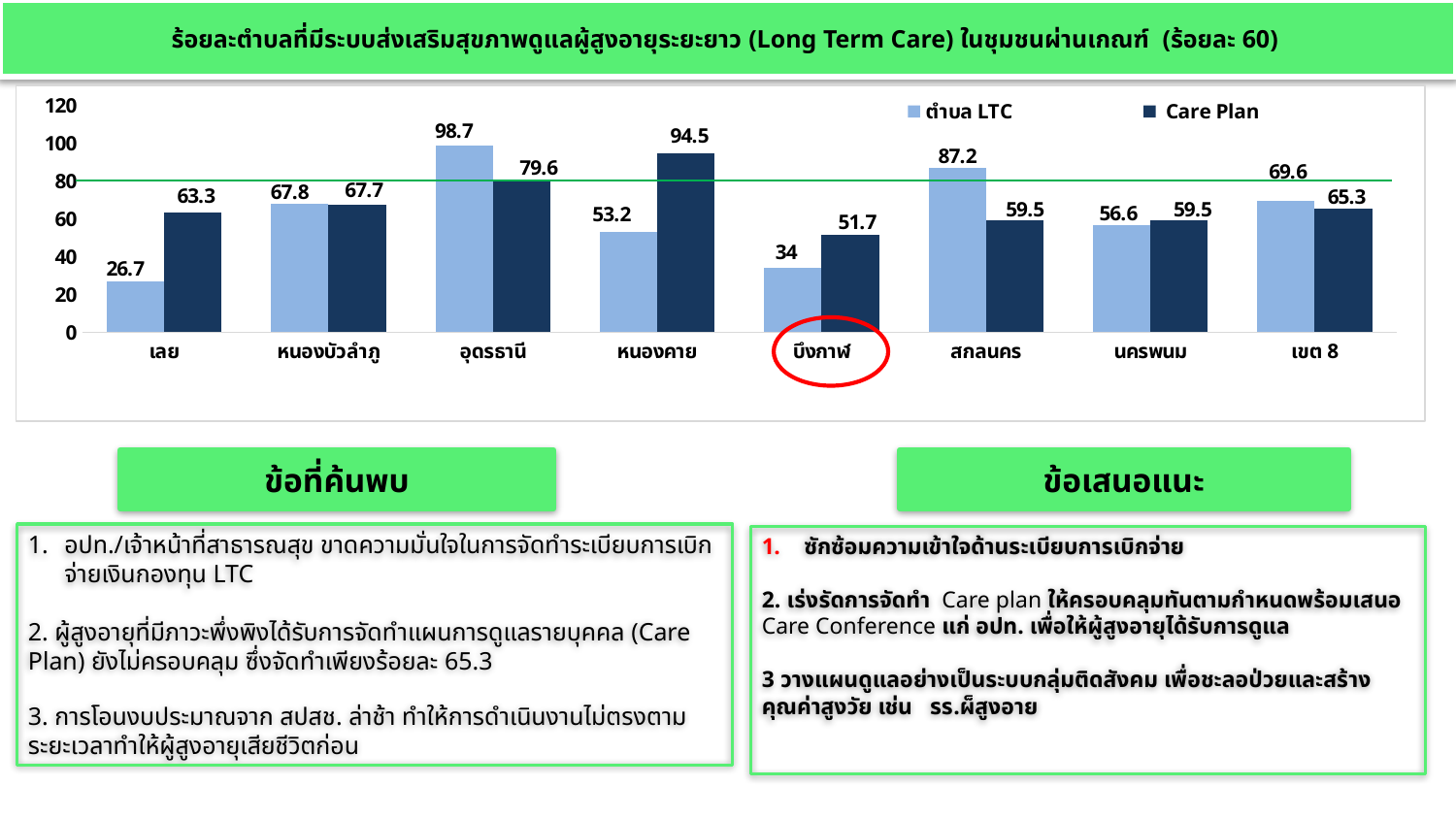
What is the ตำบล LTC value for บึงกาฬ? 34 Which category has the highest ตำบล LTC value? อุดรธานี What is the difference between the Care Plan and ตำบล LTC values for เลย? 36.6 Which category has the lowest ตำบล LTC value? เลย Which category has the lowest Care Plan value? บึงกาฬ How many series does the legend list? 2 How many categories are shown on the x axis? 8 What is the Care Plan value for หนองคาย? 94.5 What kind of chart is shown on the slide? bar chart What is the ตำบล LTC value for อุดรธานี? 98.7 What is the Care Plan value for เขต 8? 65.3 For สกลนคร, which is larger: the ตำบล LTC value or the Care Plan value? ตำบล LTC